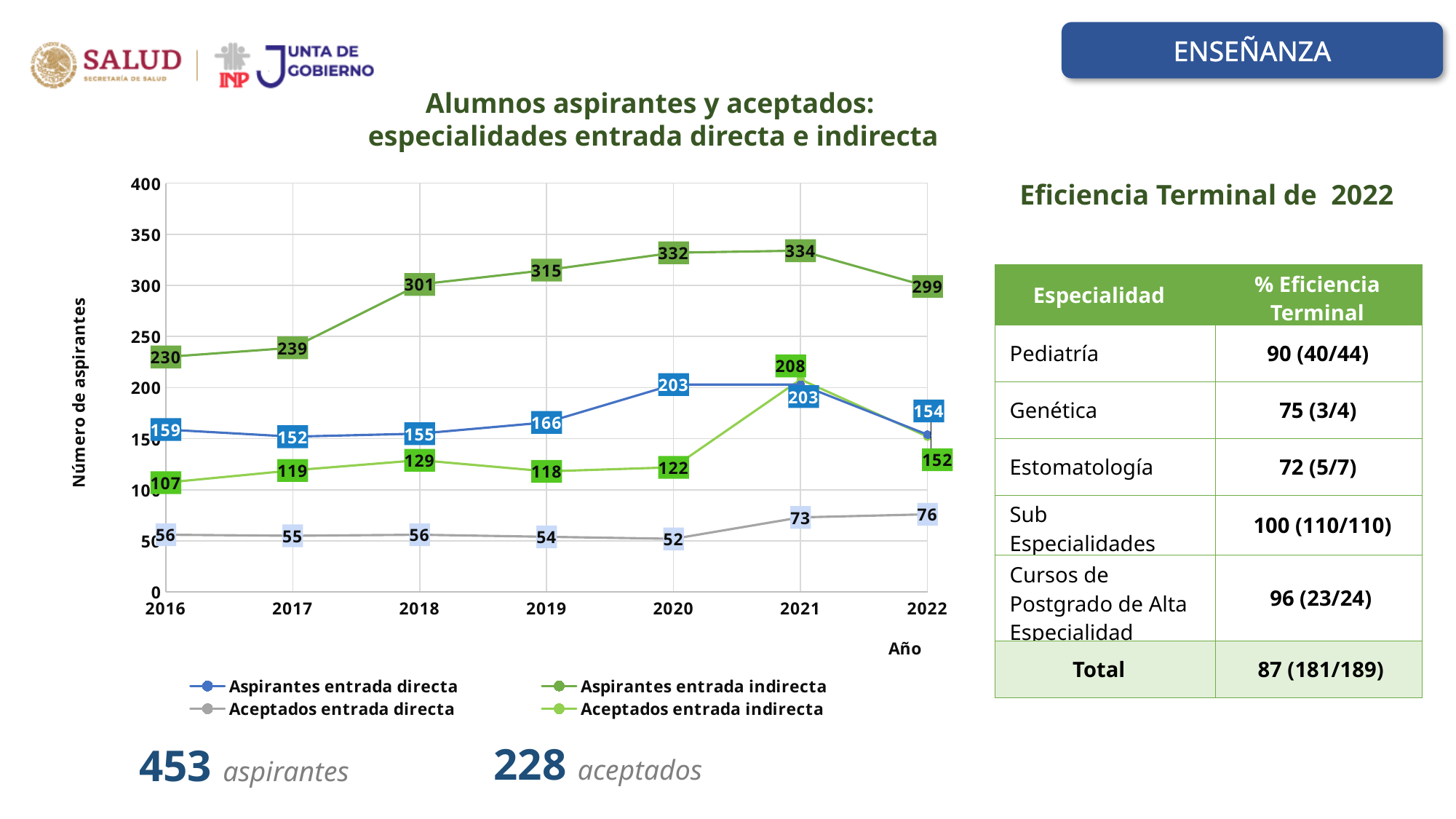
What is the difference between Aspirantes entrada indirecta and Aceptados entrada indirecta in 2018? 172 Does Aspirantes entrada indirecta rise or fall from 2016 to 2021? rise What is the value for Aceptados entrada directa in 2021? 73 How many years are plotted along the x axis of the chart? 7 In which year is Aceptados entrada directa lowest? 2020 What is the title of the chart? Alumnos aspirantes y aceptados: especialidades entrada directa e indirecta Which is larger in 2021: Aceptados entrada indirecta or Aspirantes entrada directa? Aceptados entrada indirecta What type of chart is shown on the slide? line chart What is the value for Aspirantes entrada indirecta in 2020? 332 How many series does the chart legend list? 4 What is the value for Aspirantes entrada directa in 2019? 166 In which year is Aspirantes entrada indirecta highest? 2021